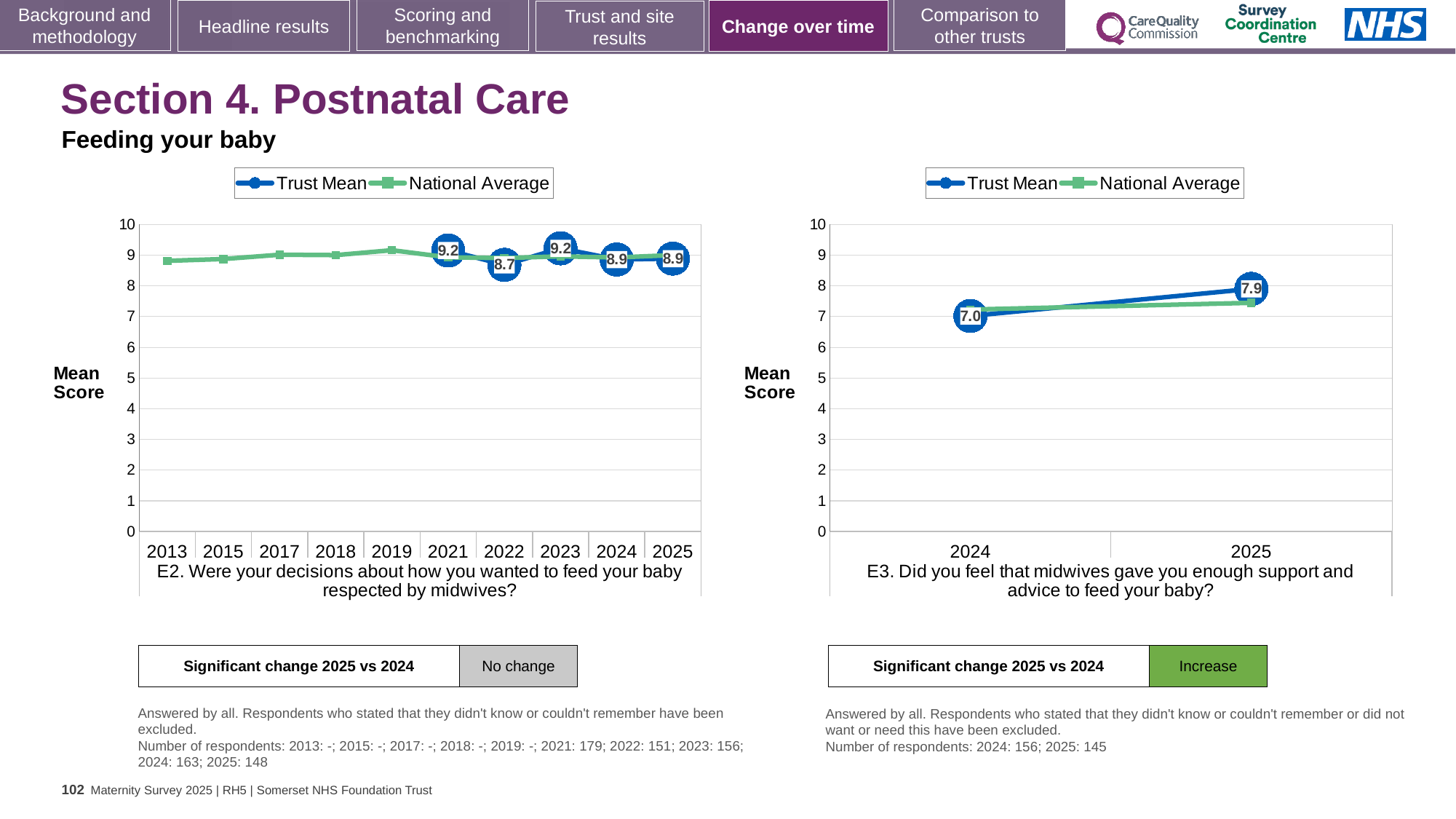
On the left chart (E2), which year has the lowest labelled Trust Mean? 2022 On the left chart (E2), what is the Trust Mean for 2022? 8.7 How many years are shown on the x axis of the left chart (E2)? 10 On the right chart (E3), what is the difference between the Trust Mean for 2025 and 2024? 0.9 On the right chart (E3), what is the Trust Mean for 2024? 7.0 How many series does the legend of the right chart (E3) list? 2 On the left chart (E2), what is the difference between the Trust Mean for 2021 and 2022? 0.5 What type of chart is the right chart (E3)? Line chart On the left chart (E2), what is the Trust Mean for 2025? 8.9 On the right chart (E3), is the Trust Mean higher in 2024 or 2025? 2025 On the right chart (E3), what is the Trust Mean for 2025? 7.9 On the left chart (E2), is the National Average for 2013 greater or less than 8? greater